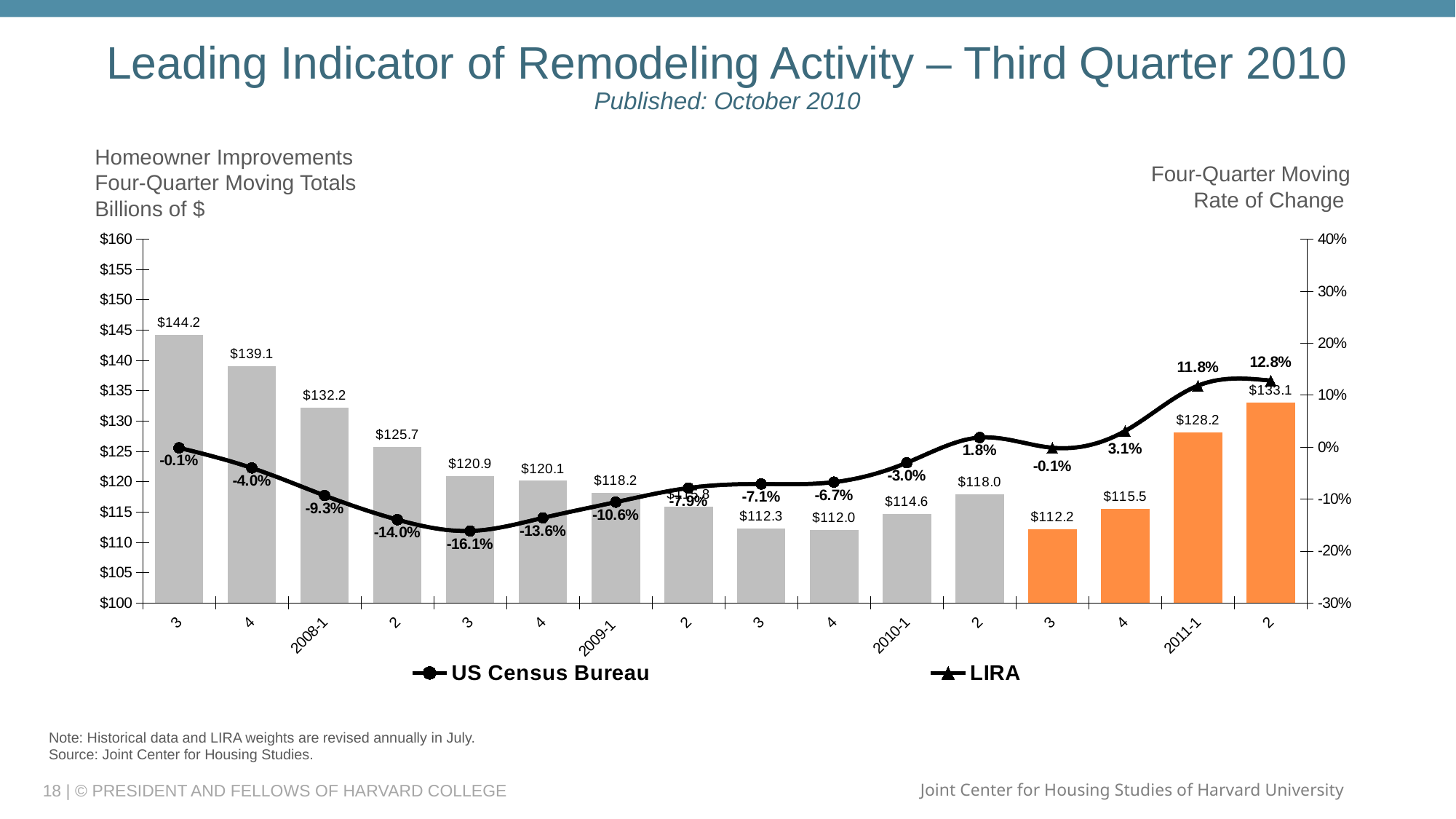
What is the lowest four-quarter moving rate of change shown on the chart? -16.1% What is the highest homeowner improvements bar value on the chart? $144.2 Is the rate of change for quarter 2 of 2011 greater or less than 10%? greater Which has the larger homeowner improvements value, 2010-1 or quarter 2 of 2010? Quarter 2 of 2010 How many bars are plotted on the chart? 16 What is the homeowner improvements value for 2008-1? $132.2 What colour are the bars for the 2011 quarters? Orange What is the difference between the homeowner improvements values for 2011-2 and 2011-1? $4.9 What is the lowest homeowner improvements bar value on the chart? $112.0 How many series does the legend list? 2 What is the rate of change shown for quarter 2 of 2010? 1.8% What is the four-quarter moving rate of change for 2011-1? 11.8%